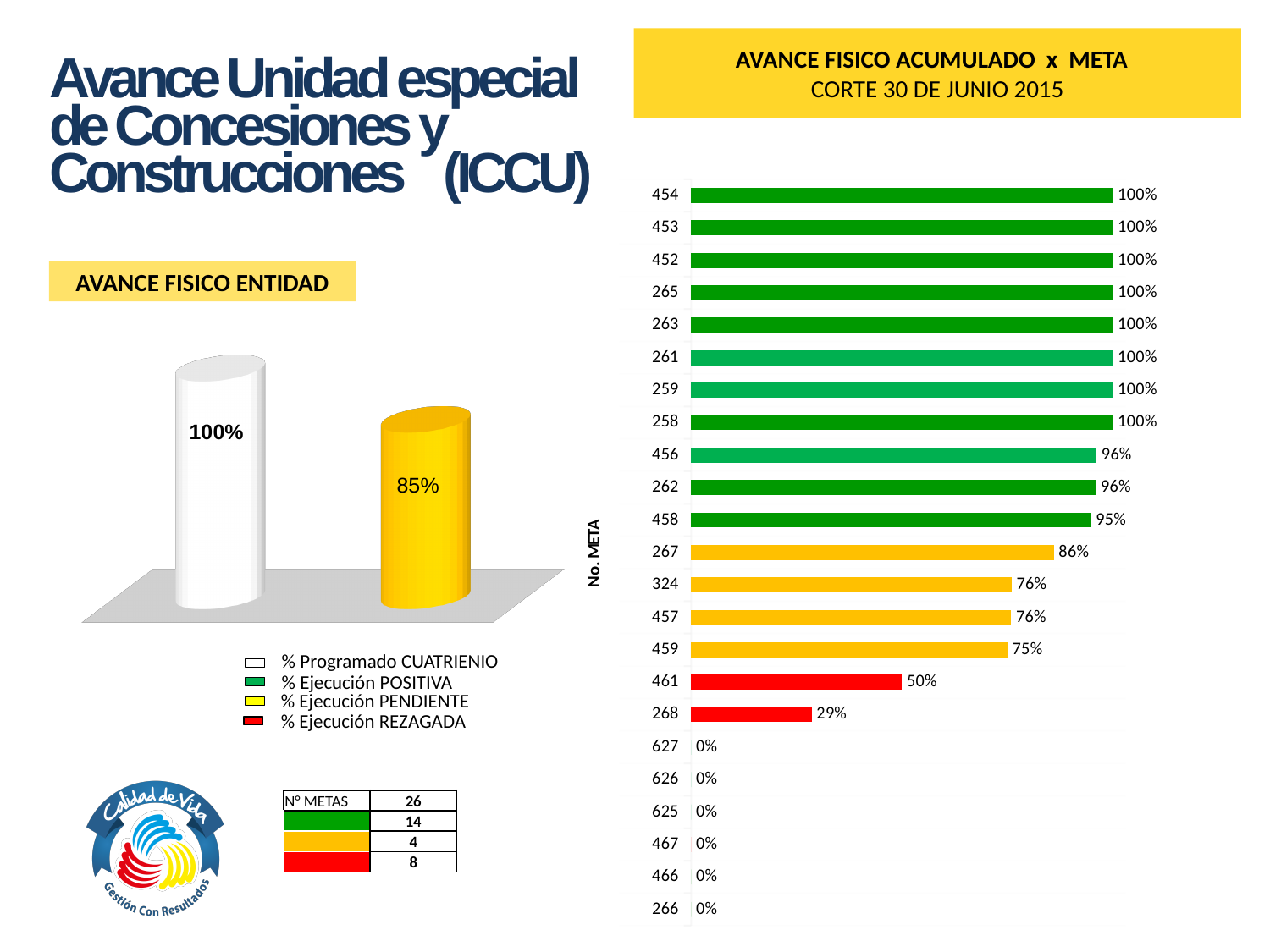
In the 'AVANCE FISICO ACUMULADO x META' chart, which is larger, the value for meta 324 or the value for meta 461? 324 In the 'AVANCE FISICO ENTIDAD' chart, what is the difference between the two plotted values? 15% In the 'AVANCE FISICO ACUMULADO x META' chart, what is the value for meta 458? 95% In the 'AVANCE FISICO ACUMULADO x META' chart, what is the value for meta 267? 86% In the 'AVANCE FISICO ENTIDAD' chart, what is the value for '% Programado CUATRIENIO'? 100% In the 'AVANCE FISICO ACUMULADO x META' chart, what is the value for meta 461? 50% In the 'AVANCE FISICO ENTIDAD' chart, what is the value of the yellow bar? 85% How many entries does the legend of the 'AVANCE FISICO ENTIDAD' chart list? 4 In the 'AVANCE FISICO ACUMULADO x META' chart, how many metas show a value of 0%? 6 In the 'AVANCE FISICO ACUMULADO x META' chart, what is the difference between the values for meta 267 and meta 459? 11% In the 'AVANCE FISICO ACUMULADO x META' chart, what is the value for meta 268? 29% What kind of chart is 'AVANCE FISICO ACUMULADO x META'? Bar chart